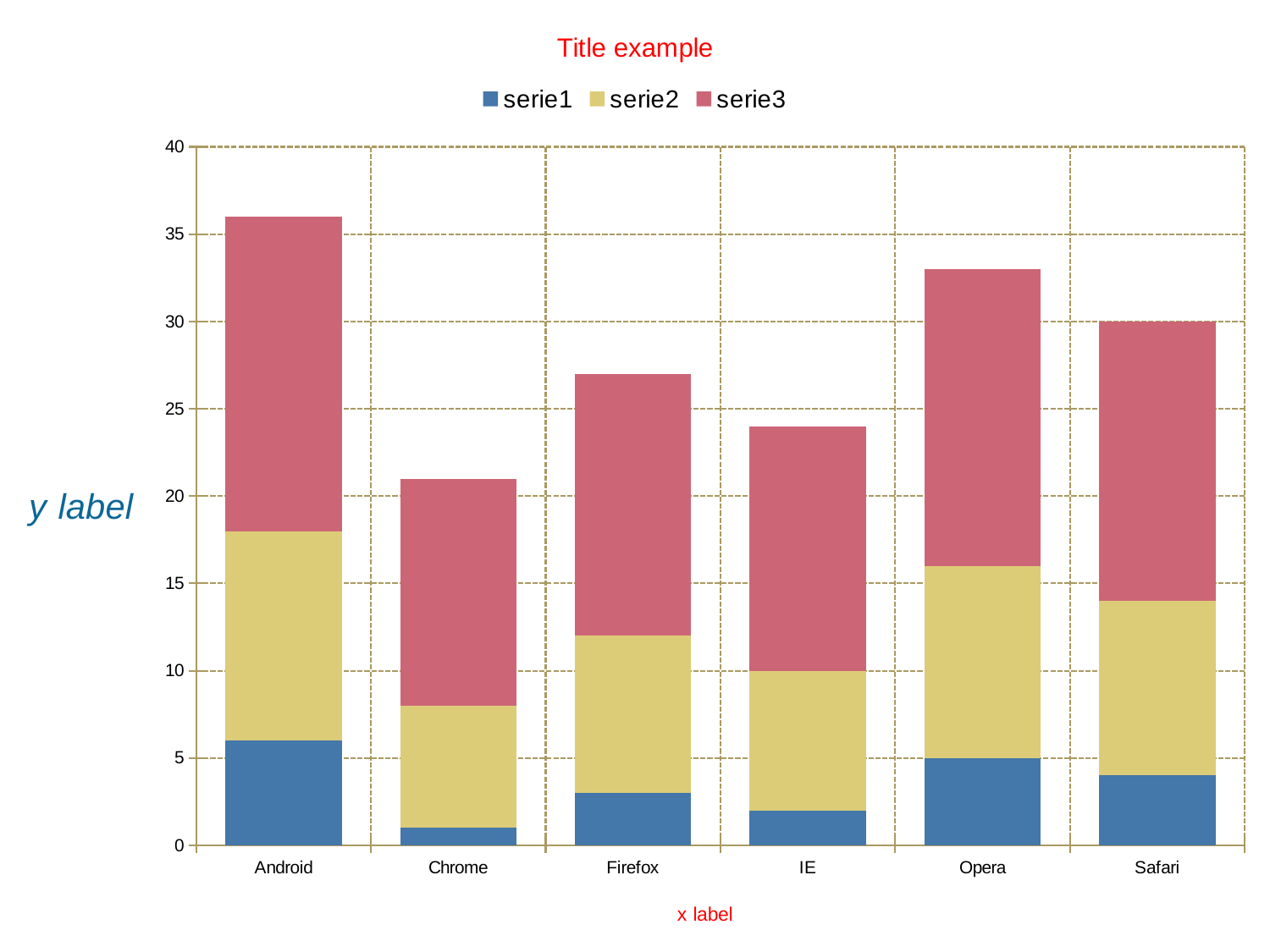
Is the total stacked bar for Android greater or less than 30? greater Is the total stacked bar for Chrome greater or less than 25? less What kind of chart is shown on the slide? stacked bar chart Which category has the highest total stacked bar? Android What is the value of serie1 for Opera? 5 How many categories are shown on the x axis? 6 Which has the larger total stacked bar, Opera or Safari? Opera How many series does the legend list? 3 Is the total stacked bar for IE greater or less than 30? less What is the total height of the stacked bar for Safari? 30 Which category has the lowest total stacked bar? Chrome What is the title of the chart? Title example